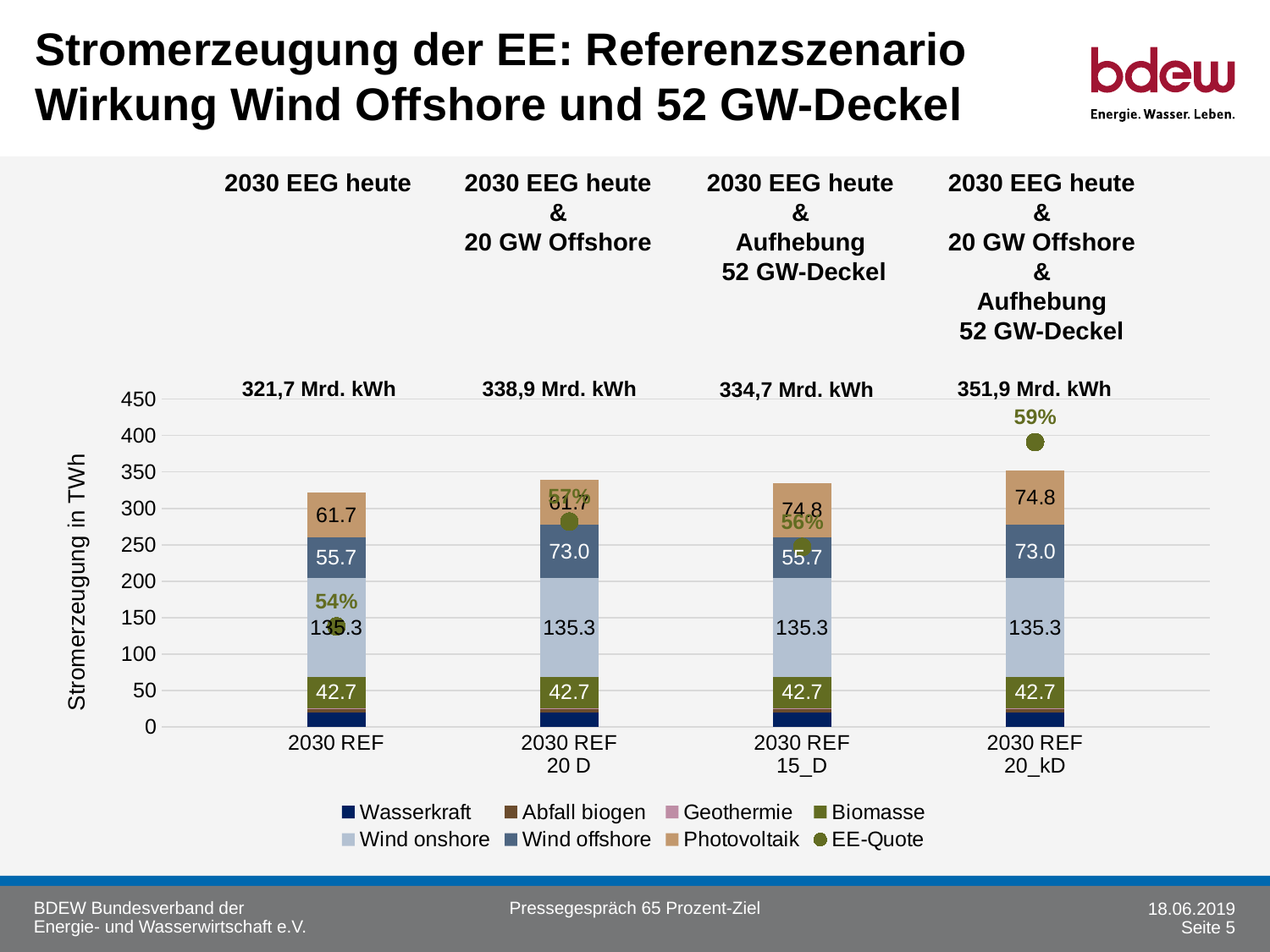
Which bar has the lowest EE-Quote? 2030 REF How many bars (categories) are shown on the x axis? 4 What is the Wind onshore value for the 2030 REF bar? 135.3 What is the difference between the Wind offshore values of 2030 REF 20 D and 2030 REF? 17.3 Which bar has the highest total generation? 2030 REF 20_kD Which is larger: the Photovoltaik value for 2030 REF 15_D or for 2030 REF? 2030 REF 15_D What is the Wind offshore value for the 2030 REF 20 D bar? 73.0 What total is printed above the 2030 REF 20 D bar? 338,9 Mrd. kWh What is the Photovoltaik value for the 2030 REF 15_D bar? 74.8 What is the EE-Quote shown for the 2030 REF 20_kD bar? 59% How many entries does the legend list? 8 What type of chart is shown on the slide? stacked bar chart